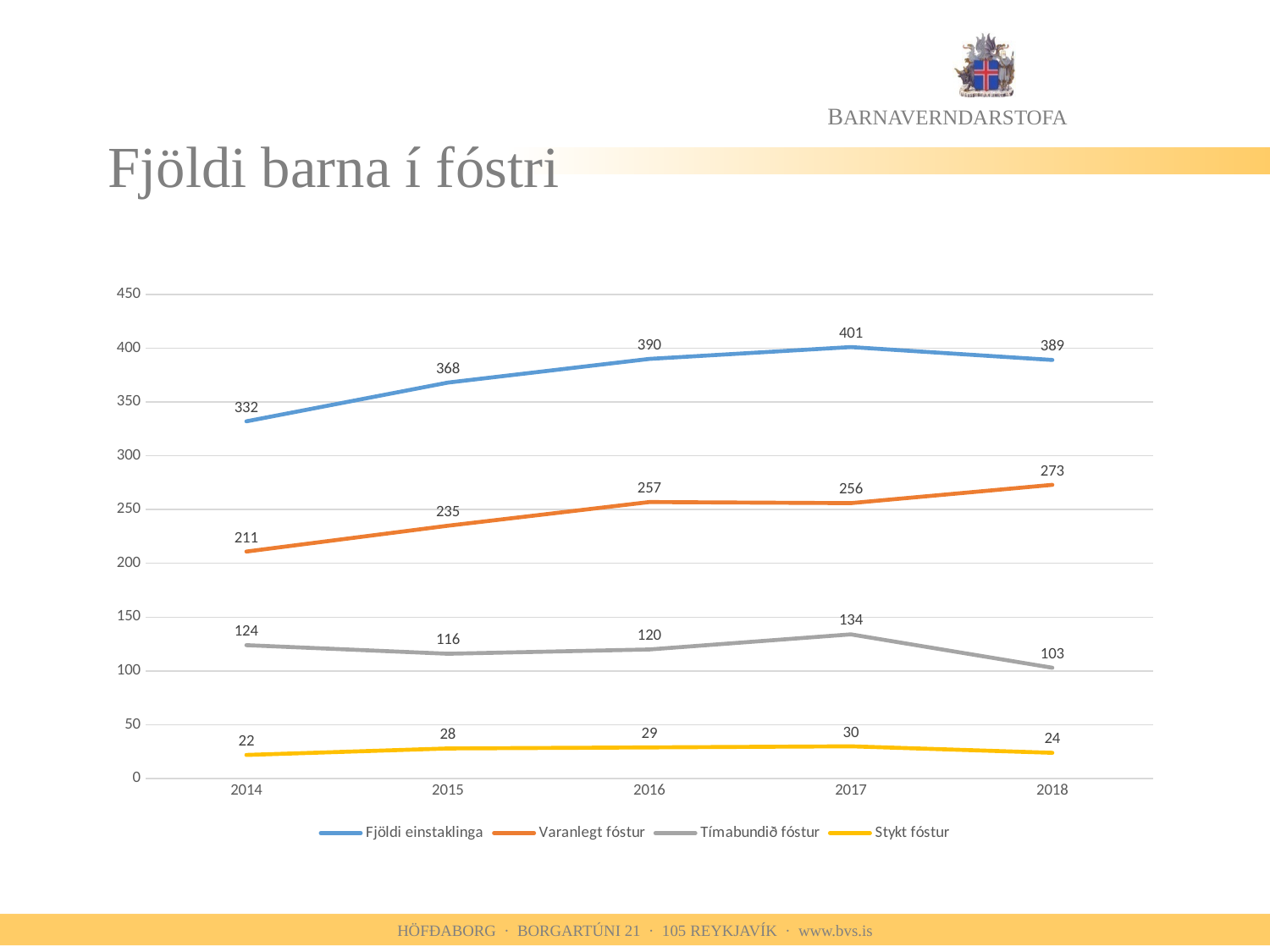
What is the value for Varanlegt fóstur in 2014? 211 What kind of chart is shown on the slide? Line chart How many series does the legend list? 4 What is the value for Fjöldi einstaklinga in 2017? 401 Does Varanlegt fóstur rise or fall from 2014 to 2018? Rise In which year is Tímabundið fóstur lowest? 2018 How many years are shown on the x axis? 5 Which is larger: Tímabundið fóstur in 2017 or in 2015? 2017 What is the value for Stykt fóstur in 2016? 29 What is the difference between Varanlegt fóstur in 2018 and in 2014? 62 In which year is Fjöldi einstaklinga highest? 2017 What is the value for Tímabundið fóstur in 2018? 103